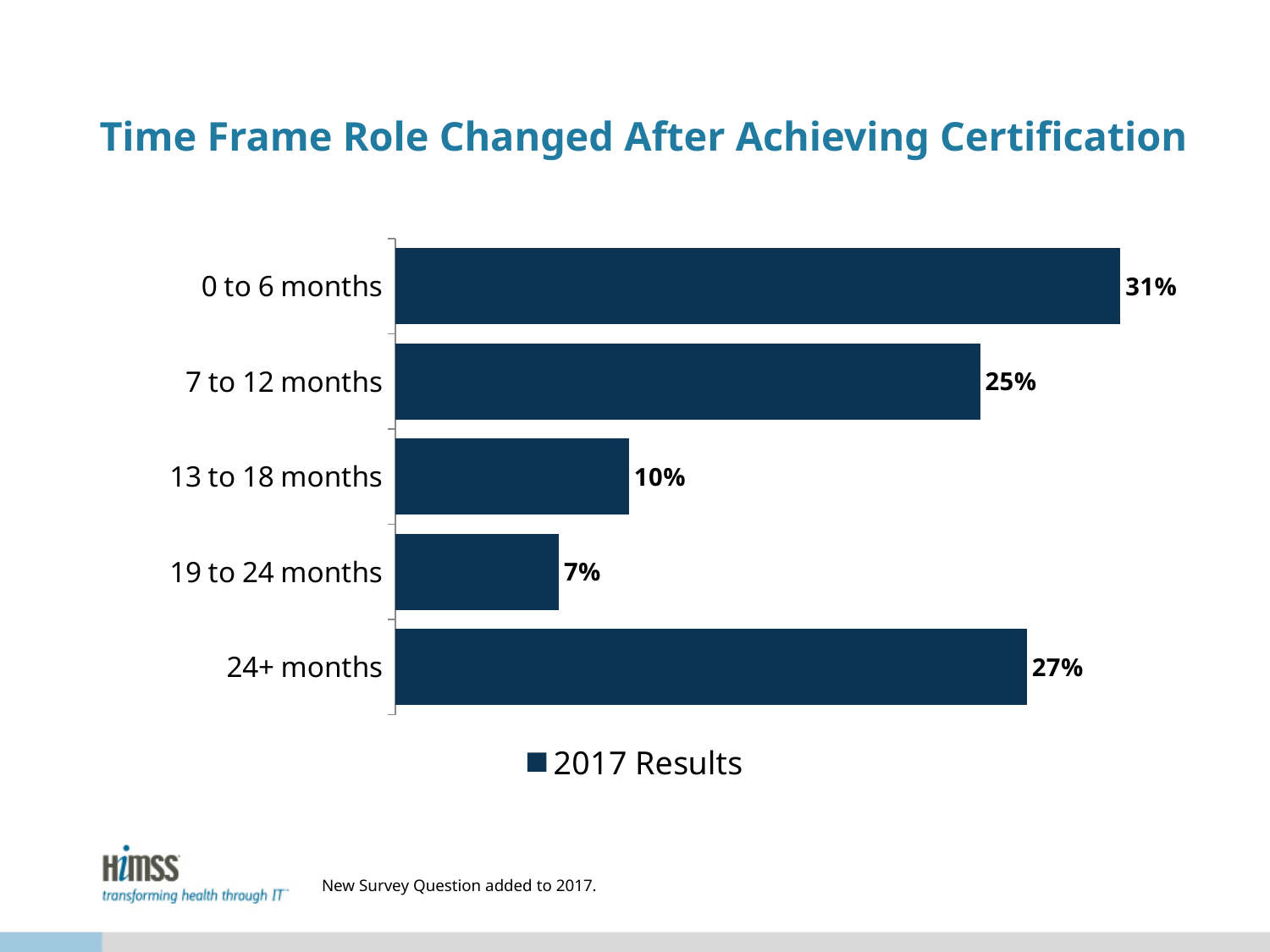
What series does the legend list? 2017 Results Which is larger, the value for 7 to 12 months or the value for 24+ months? 24+ months What is the value for 7 to 12 months? 25% What kind of chart is shown on the slide? Bar chart What is the value for 13 to 18 months? 10% What is the value for 24+ months? 27% Which time frame has the highest value? 0 to 6 months What is the difference between the values for 0 to 6 months and 24+ months? 4% What is the value for 19 to 24 months? 7% Which time frame has the lowest value? 19 to 24 months What is the value for 0 to 6 months? 31% How many time frame categories are shown in the chart? 5